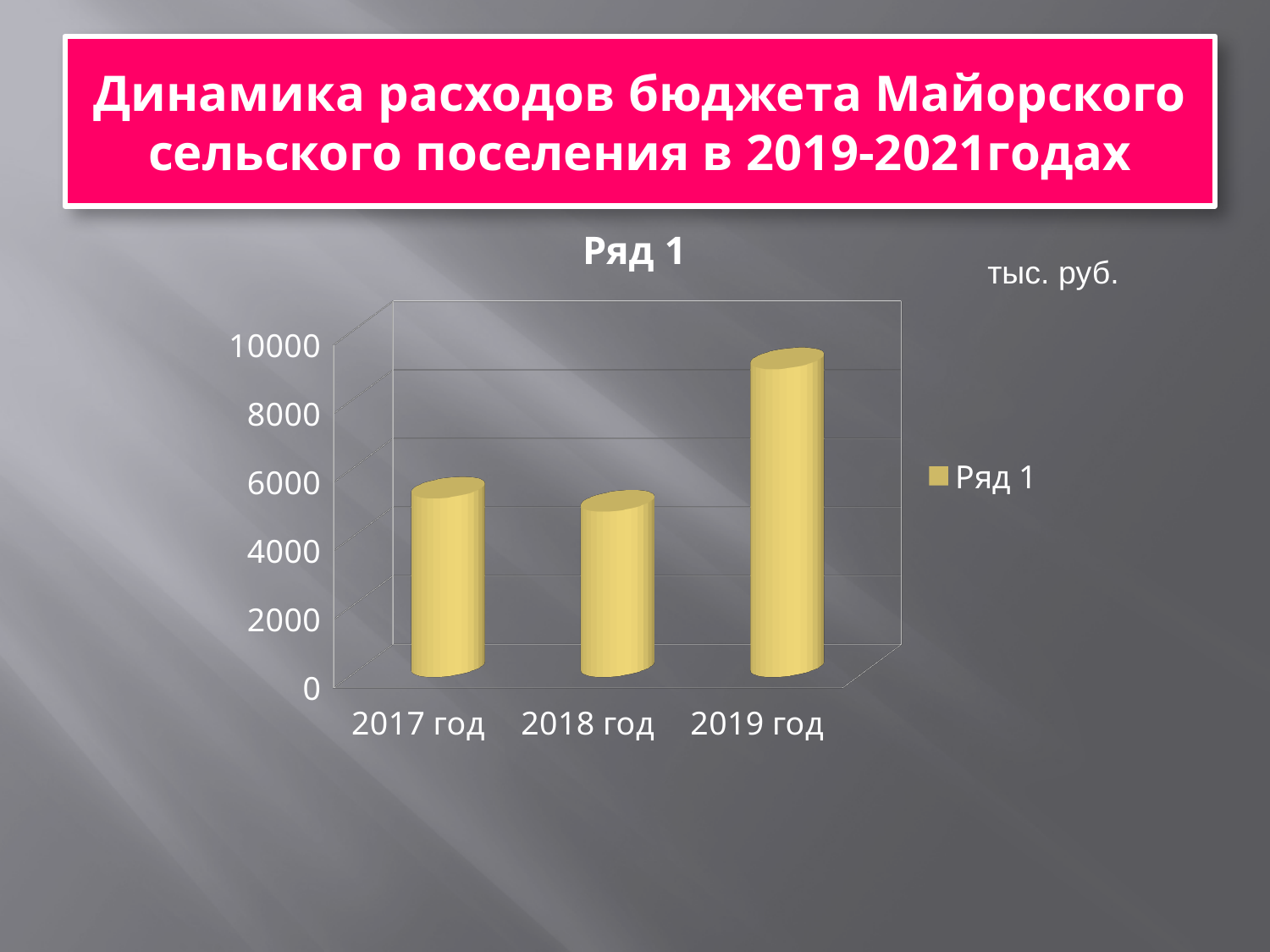
Is the value for 2019 год greater or less than 8000? greater Is the value for 2018 год greater or less than 4000? greater Which year has the highest value in the chart? 2019 год Is the value for 2019 год larger or smaller than the value for 2018 год? larger Is the value for 2017 год greater or less than 8000? less How many categories (years) are shown on the x axis of the chart? 3 How many series does the chart legend list? 1 Does the value rise or fall from 2018 год to 2019 год? rise What is the name of the series shown in the chart legend? Ряд 1 What kind of chart is shown on the slide? bar chart